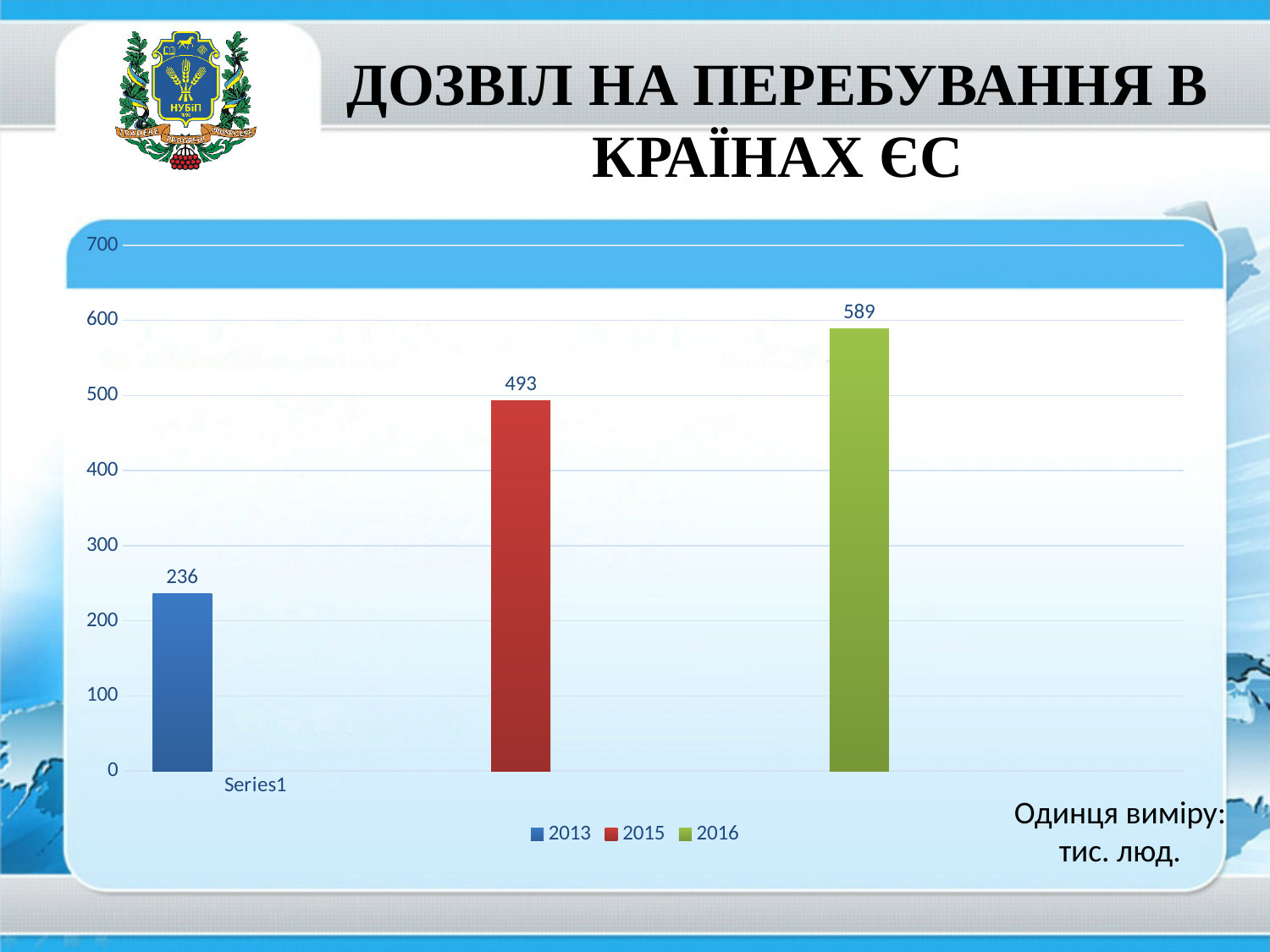
Which year has the highest value? 2016 How many series does the legend list? 3 What kind of chart is shown on the slide? bar chart What is the value for 2013? 236 What is the value for 2016? 589 Is the value for 2015 greater or less than 400? greater Which year has the lowest value? 2013 What is the difference between the values for 2016 and 2015? 96 What is the value for 2015? 493 What unit of measurement is stated on the slide for the chart values? тис. люд. What is the difference between the values for 2016 and 2013? 353 Which is larger, the value for 2015 or the value for 2013? 2015